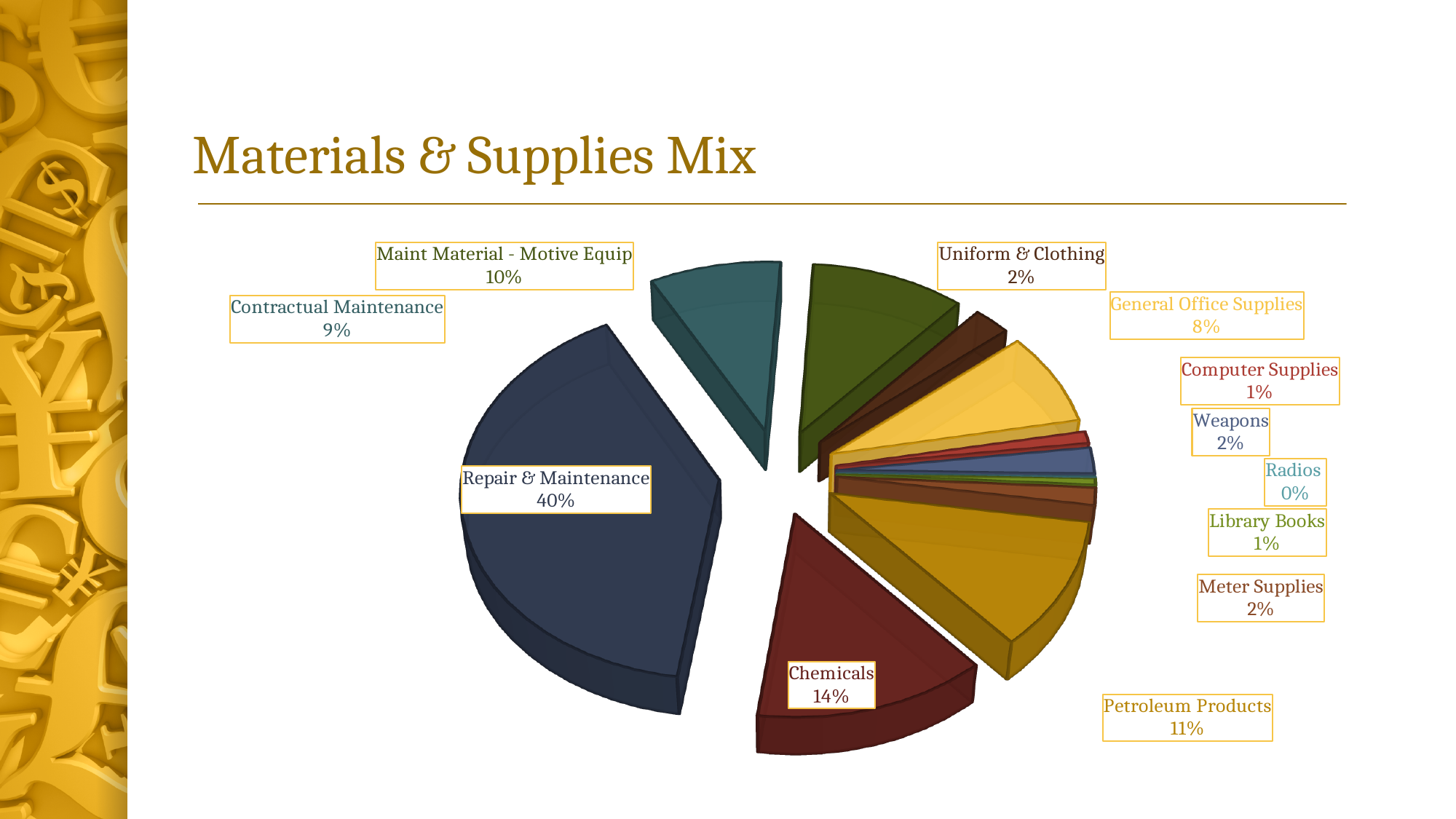
What percentage is shown for Chemicals? 14% What percentage is shown for Computer Supplies? 1% What share of the pie is Repair & Maintenance? 40% What is the title of the chart? Materials & Supplies Mix Which category has the largest share of the pie? Repair & Maintenance What percentage is shown for General Office Supplies? 8% What kind of chart is shown on the slide? Pie chart Which is larger, Maint Material - Motive Equip or Contractual Maintenance? Maint Material - Motive Equip What is the difference in percentage points between Repair & Maintenance and Chemicals? 26 What percentage is shown for Petroleum Products? 11% Which category has the smallest share of the pie? Radios How many categories are shown in the pie chart? 12